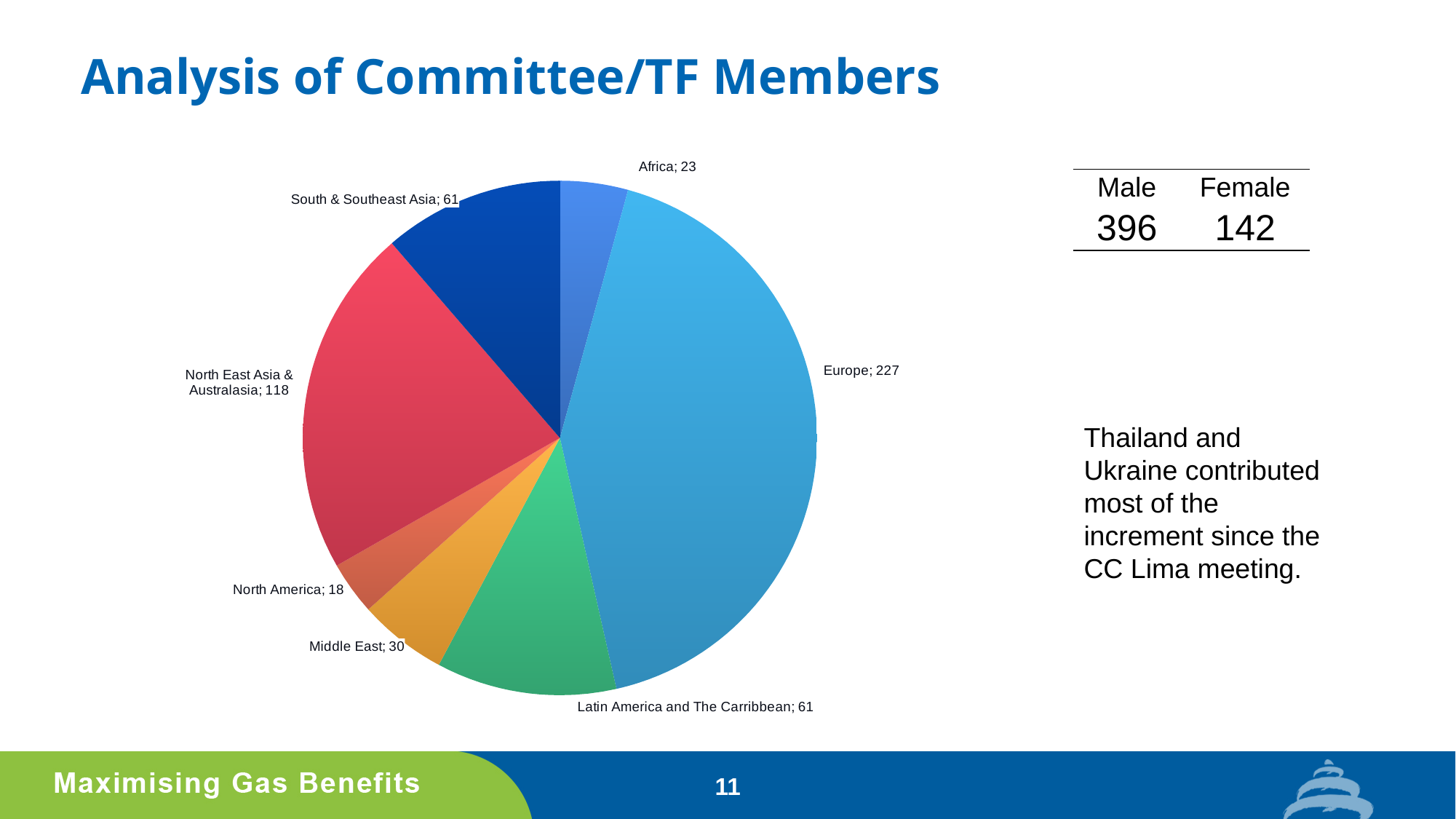
Which region has the largest slice of the pie chart? Europe What is the value shown for the Middle East slice? 30 What is the value shown for North America in the pie chart? 18 What value is shown for Latin America and The Carribbean? 61 What colour is the Europe slice of the pie chart? Light blue What type of chart is shown on the slide? Pie chart What is the total of all the values shown in the pie chart? 538 How many members does the pie chart show for Europe? 227 What is the difference between the Europe value and the North East Asia & Australasia value? 109 Which is larger, the Middle East slice or the Africa slice? Middle East Which region has the smallest slice of the pie chart? North America How many regions are shown in the pie chart? 7